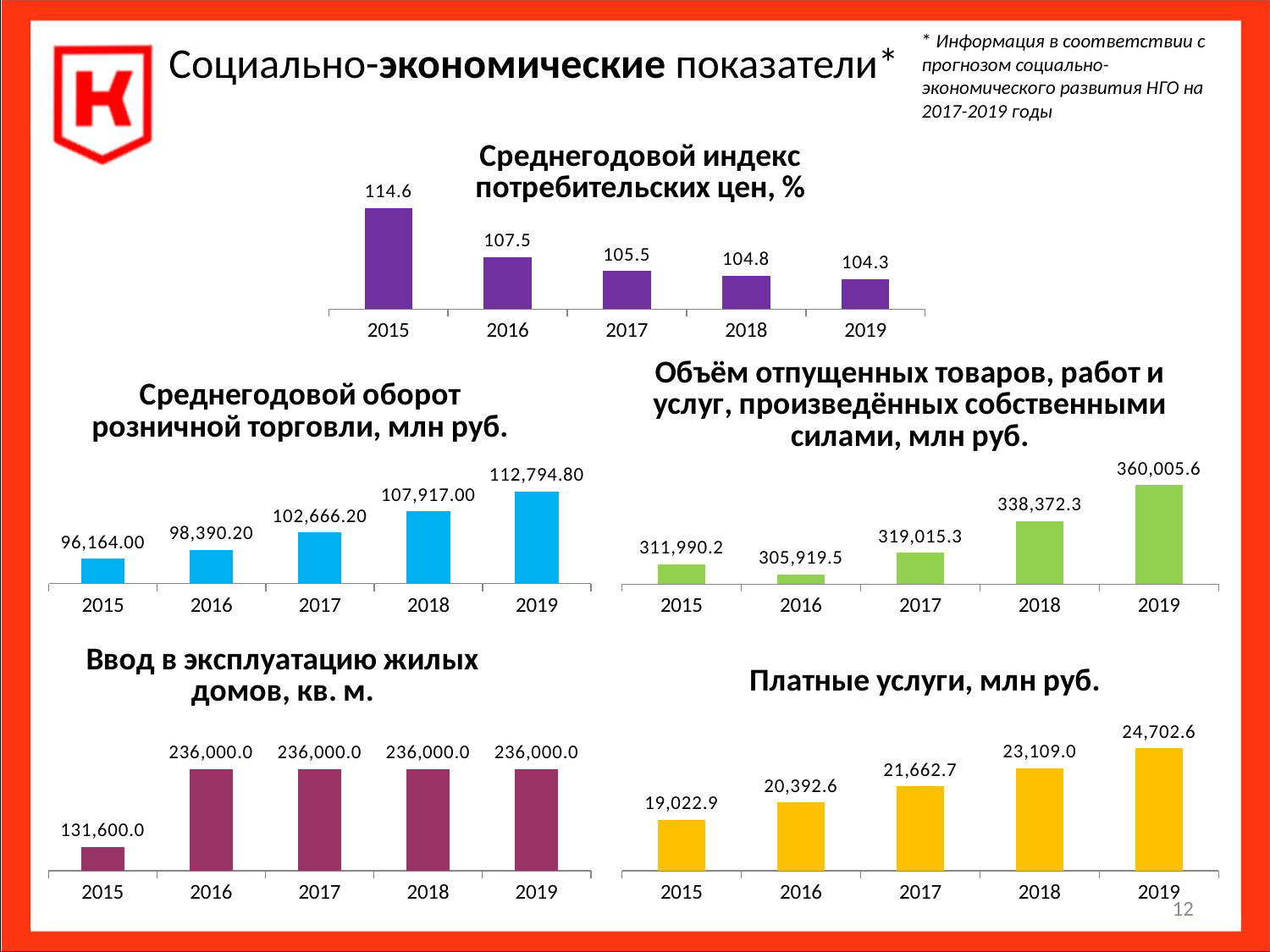
In the chart 'Среднегодовой оборот розничной торговли, млн руб.', what is the difference between the 2019 and 2015 values? 16,630.80 In the chart 'Платные услуги, млн руб.', which year has the highest value? 2019 In the chart 'Среднегодовой индекс потребительских цен, %', do the values rise or fall from 2015 to 2019? fall In the chart 'Среднегодовой индекс потребительских цен, %', which year has the lowest value? 2019 In the chart 'Среднегодовой индекс потребительских цен, %', what is the value for 2015? 114.6 In the chart 'Объём отпущенных товаров, работ и услуг, произведённых собственными силами, млн руб.', which year has the lowest value? 2016 In the chart 'Среднегодовой оборот розничной торговли, млн руб.', what is the value for 2017? 102,666.20 In the chart 'Ввод в эксплуатацию жилых домов, кв. м.', how many years are shown on the x axis? 5 In the chart 'Объём отпущенных товаров, работ и услуг, произведённых собственными силами, млн руб.', what is the value for 2018? 338,372.3 In the chart 'Платные услуги, млн руб.', which is larger: the value for 2016 or the value for 2017? 2017 What type of chart is 'Платные услуги, млн руб.'? bar chart In the chart 'Ввод в эксплуатацию жилых домов, кв. м.', what is the value for 2015? 131,600.0